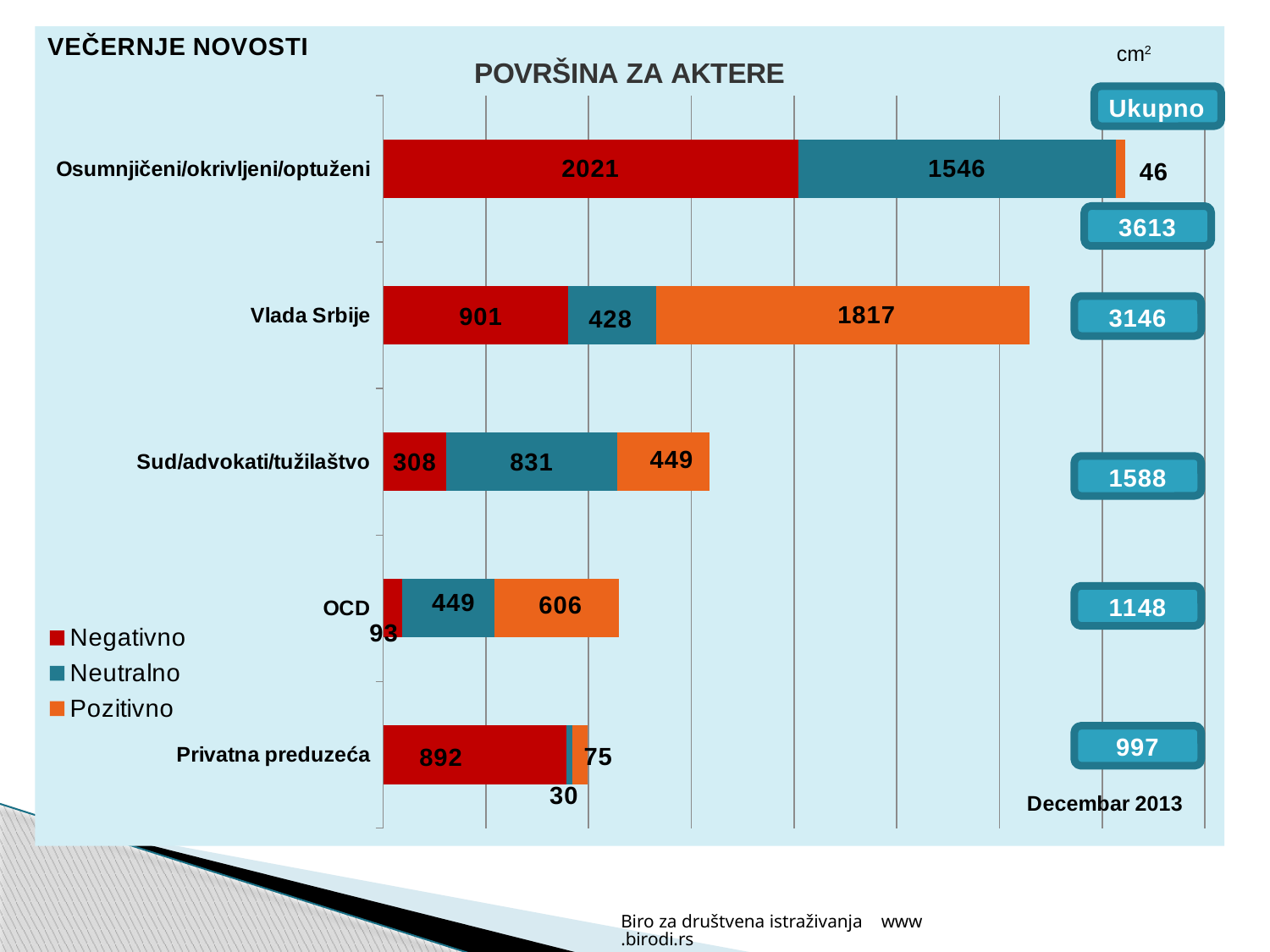
Which category has the highest total (Ukupno)? Osumnjičeni/okrivljeni/optuženi How many series does the legend list? 3 What is the Neutralno value for Sud/advokati/tužilaštvo? 831 What is the Pozitivno value for Vlada Srbije? 1817 How many categories (actors) are shown on the chart? 5 What is the Negativno value for Osumnjičeni/okrivljeni/optuženi? 2021 What is the difference between the Negativno values for Vlada Srbije and Privatna preduzeća? 9 Which is larger: the Pozitivno value for OCD or the Pozitivno value for Sud/advokati/tužilaštvo? OCD What is the total (Ukupno) for OCD? 1148 What type of chart is shown on the slide? stacked bar chart Which category has the lowest total (Ukupno)? Privatna preduzeća What is the title of the chart? POVRŠINA ZA AKTERE